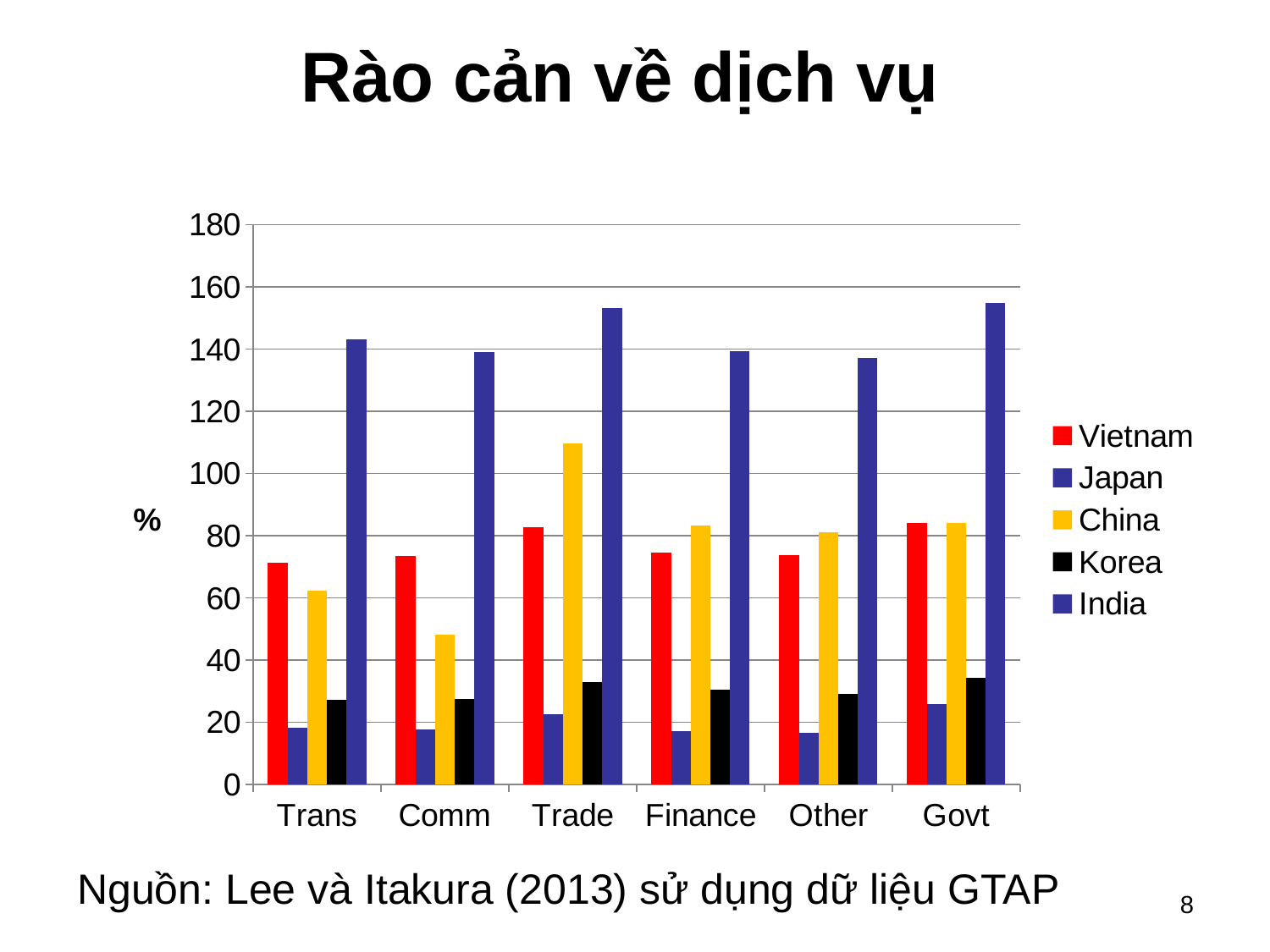
Which series has the lowest value in the Trade category? Japan Is the value for China in Trade greater or less than 100? greater Is the value for India in Trans greater or less than 120? greater Which category has the lowest value for China? Comm Which series has the highest value in the Trans category? India What label is shown on the vertical axis? % In the Trade category, which is larger: the value for China or the value for Vietnam? China How many categories are shown on the x axis? 6 What kind of chart is shown on the slide? bar chart Is the value for Japan in Comm greater or less than 20? less How many series does the legend list? 5 Which category has the highest value for China? Trade